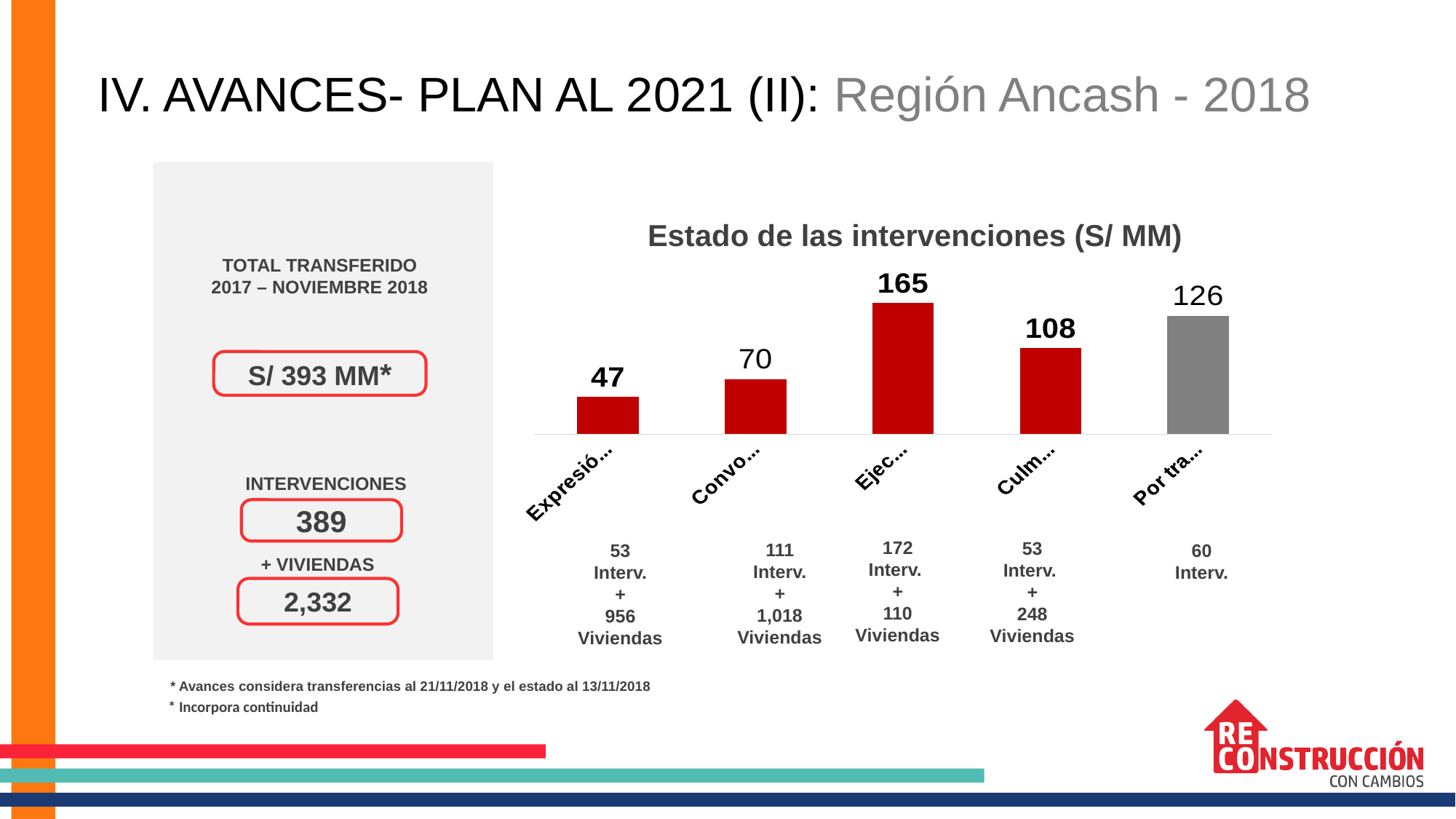
What is the value of the first bar (labelled 'Expresió...') in the chart? 47 Which bar has the highest value in the chart 'Estado de las intervenciones (S/ MM)'? Ejec... (165) What type of chart is shown on the slide? bar chart Which is larger in the chart, the 'Por tra...' bar or the 'Culm...' bar? Por tra... What is the value of the second bar (labelled 'Convo...') in the chart? 70 What is the value of the last bar (labelled 'Por tra...') in the chart? 126 Which bar has the lowest value in the chart 'Estado de las intervenciones (S/ MM)'? Expresió... (47) What is the value of the fourth bar (labelled 'Culm...') in the chart? 108 How many bars does the chart 'Estado de las intervenciones (S/ MM)' have? 5 What is the difference between the 'Ejec...' bar and the 'Culm...' bar in the chart? 57 What is the title of the chart on the slide? Estado de las intervenciones (S/ MM) What is the value of the third bar (labelled 'Ejec...') in the chart? 165